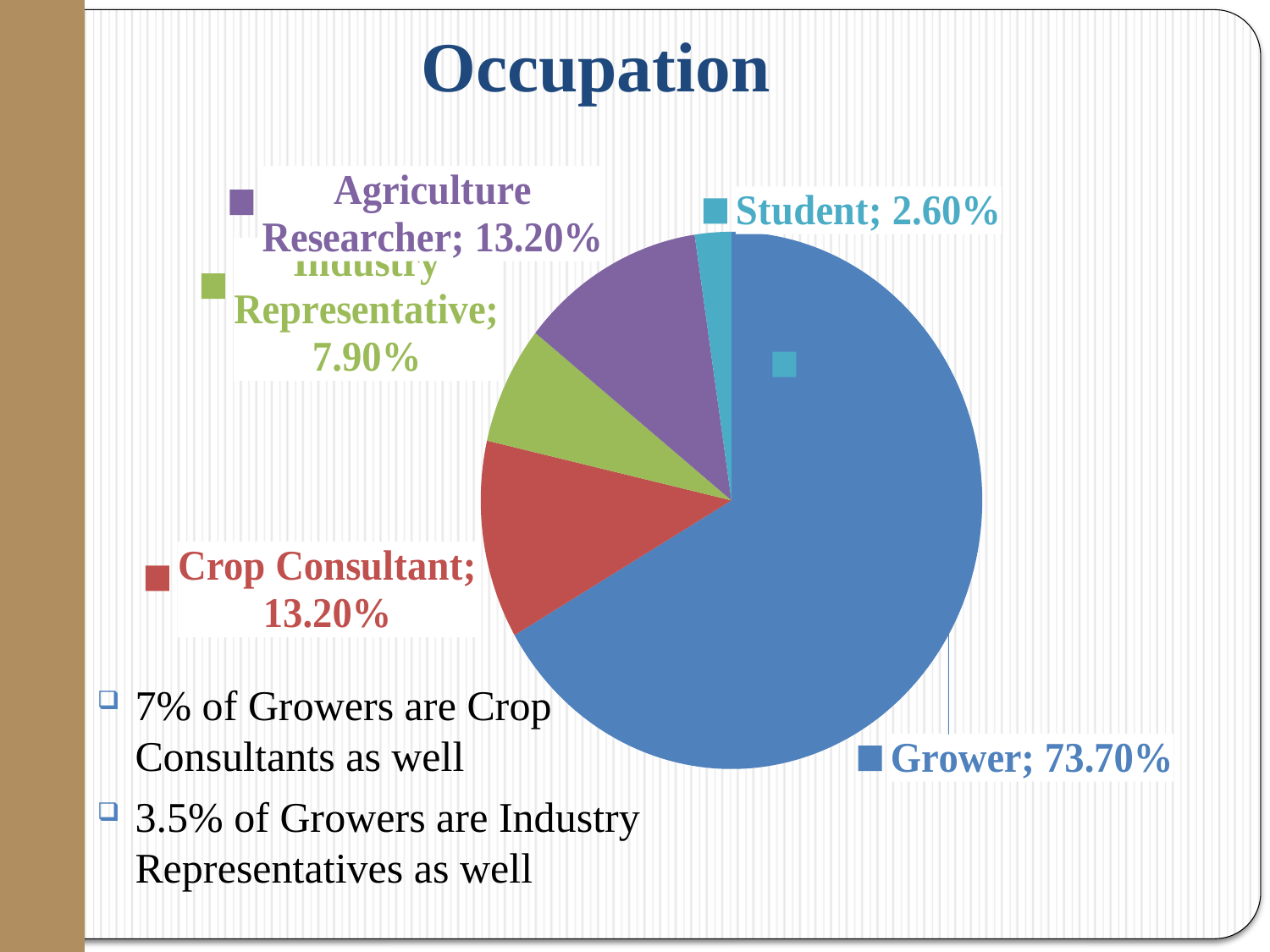
What percentage of the pie is Crop Consultant? 13.20% What percentage of the pie is Grower? 73.70% What percentage of the pie is Agriculture Researcher? 13.20% How many slices does the pie chart have? 5 What is the title of the chart? Occupation Which occupation has the largest share of the pie? Grower What is the difference between the Grower share and the Crop Consultant share? 60.50% Which is larger, the share for Industry Representative or the share for Student? Industry Representative What percentage of the pie is Industry Representative? 7.90% Which occupation has the smallest share of the pie? Student What percentage of the pie is Student? 2.60% What kind of chart is shown on the slide? pie chart